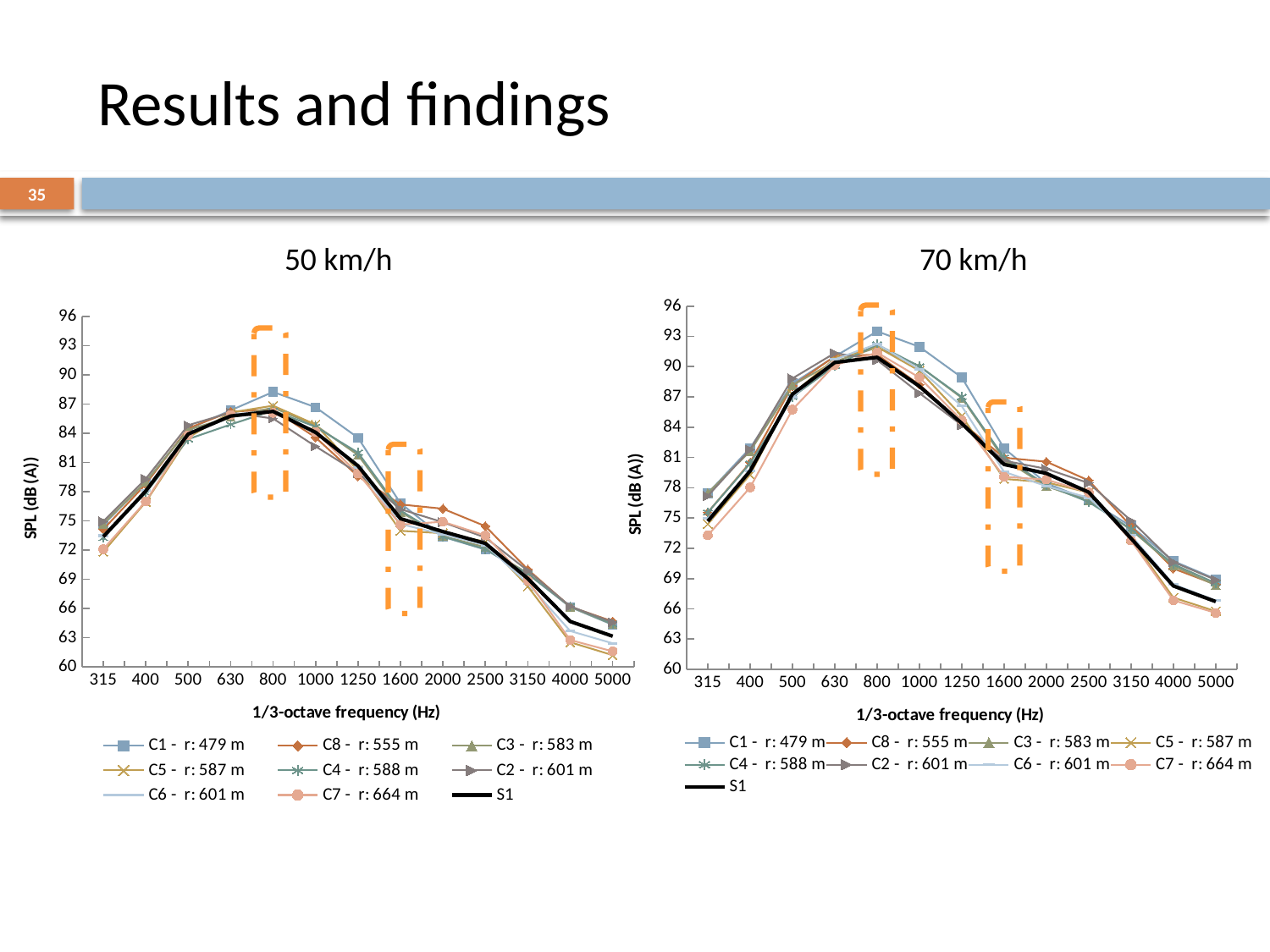
In the 70 km/h chart, which is larger at 1250 Hz: C1 - r: 479 m or S1? C1 - r: 479 m In the 70 km/h chart, is the value of S1 at 315 Hz greater or less than 72? greater What kind of chart is the 50 km/h chart? line chart In the 50 km/h chart, is the value of S1 at 4000 Hz greater or less than 66? less In the 70 km/h chart, is the value of C1 - r: 479 m at 800 Hz greater or less than 90? greater How many frequency bands are plotted along the x axis of the 50 km/h chart? 13 How many series does the legend of the 70 km/h chart list? 9 In the 70 km/h chart, at which frequency does C1 - r: 479 m reach its highest value? 800 Hz What is the x-axis title of the 50 km/h chart? 1/3-octave frequency (Hz) In the 50 km/h chart, do the S1 values rise or fall from 1000 Hz to 5000 Hz? fall What is the y-axis title of the 70 km/h chart? SPL (dB (A))